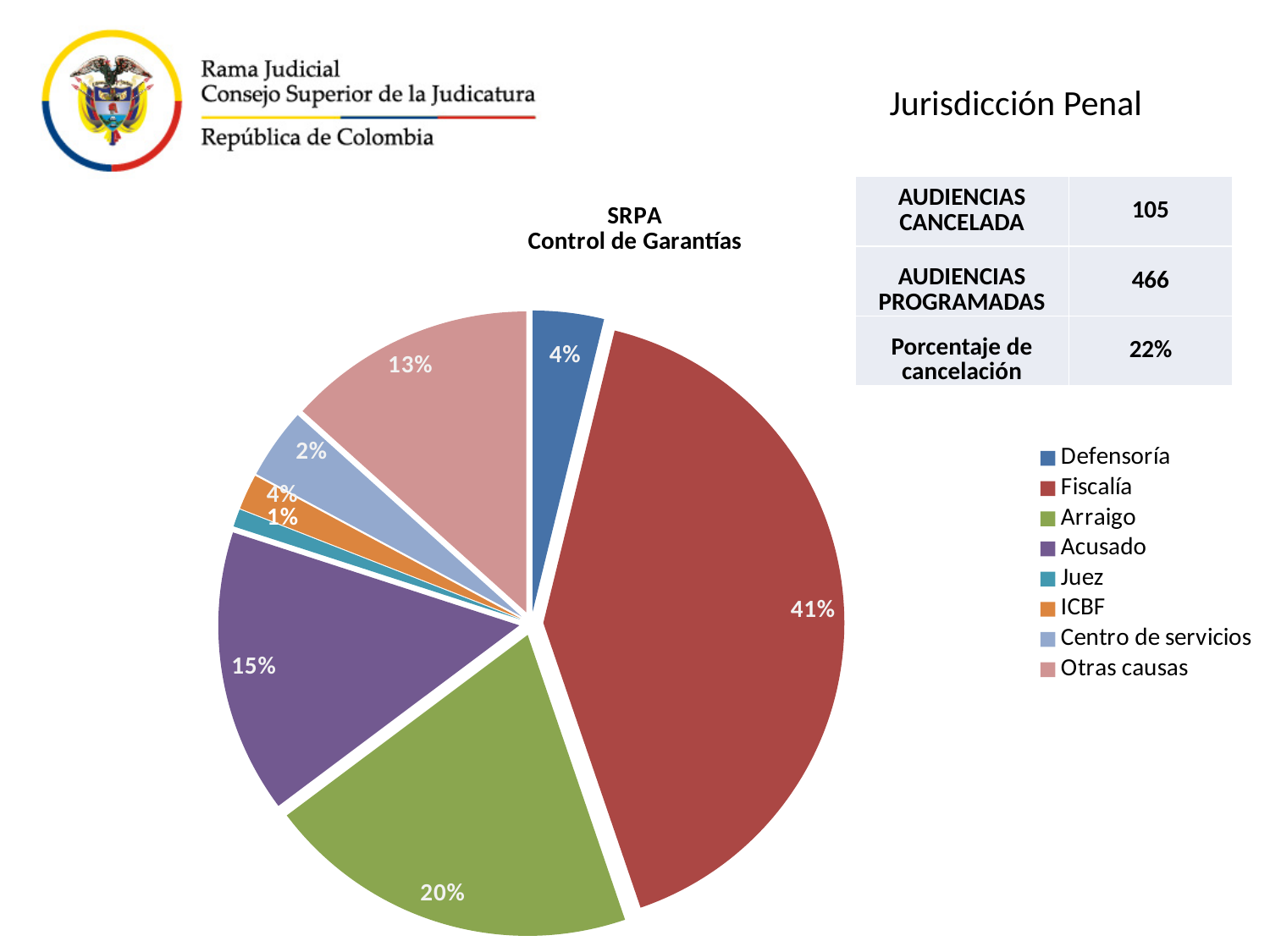
What share of the pie does Juez represent? 1% How many categories does the legend of the pie chart list? 8 Which category has the smallest slice of the pie? Juez Which slice is larger, Acusado or Otras causas? Acusado What kind of chart is shown on the slide? pie chart What share of the pie does Arraigo represent? 20% What is the title of the pie chart? SRPA Control de Garantías What share of the pie does Acusado represent? 15% Which category has the largest slice of the pie? Fiscalía What is the difference in percentage points between the Fiscalía slice and the Arraigo slice? 21